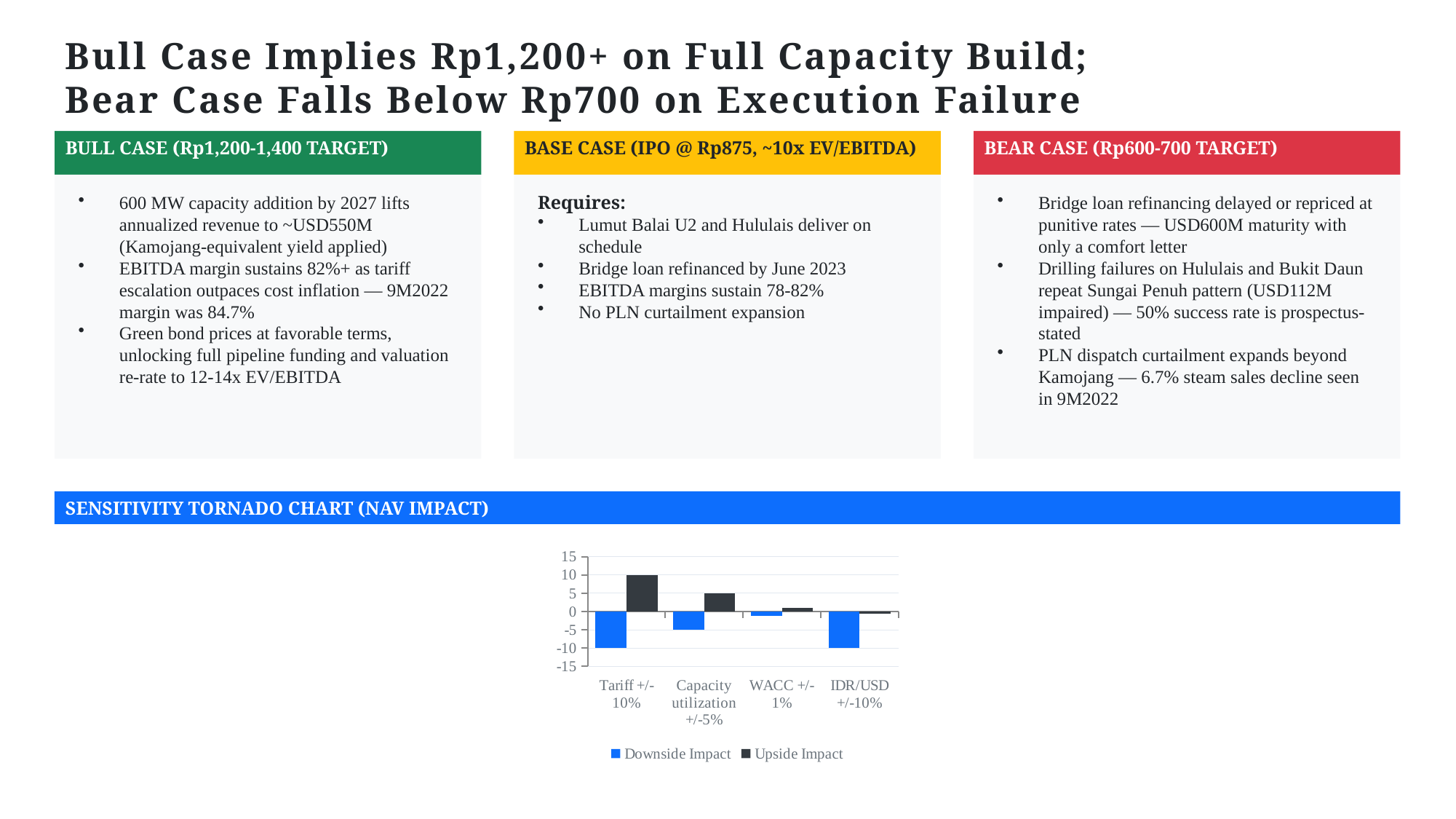
In the sensitivity chart, what is the Upside Impact value for Tariff +/- 10%? 10 What are the two series named in the legend of the sensitivity chart? Downside Impact and Upside Impact In the sensitivity chart, what is the Upside Impact value for Capacity utilization +/-5%? 5 In the sensitivity chart, which is larger: the Upside Impact for Capacity utilization +/-5% or the Upside Impact for WACC +/- 1%? Capacity utilization +/-5% How many series does the legend of the sensitivity chart list? 2 In the sensitivity chart, which category has the largest Upside Impact? Tariff +/- 10% How many categories are shown on the x axis of the sensitivity chart? 4 In the sensitivity chart, what is the Downside Impact value for Tariff +/- 10%? -10 What kind of chart is the Sensitivity Tornado Chart (NAV Impact)? Bar chart In the sensitivity chart, is the Downside Impact for IDR/USD +/-10% greater or less than -5? less In the sensitivity chart, is the Upside Impact for WACC +/- 1% greater or less than 5? less In the sensitivity chart, which category has the smallest Upside Impact? IDR/USD +/-10%